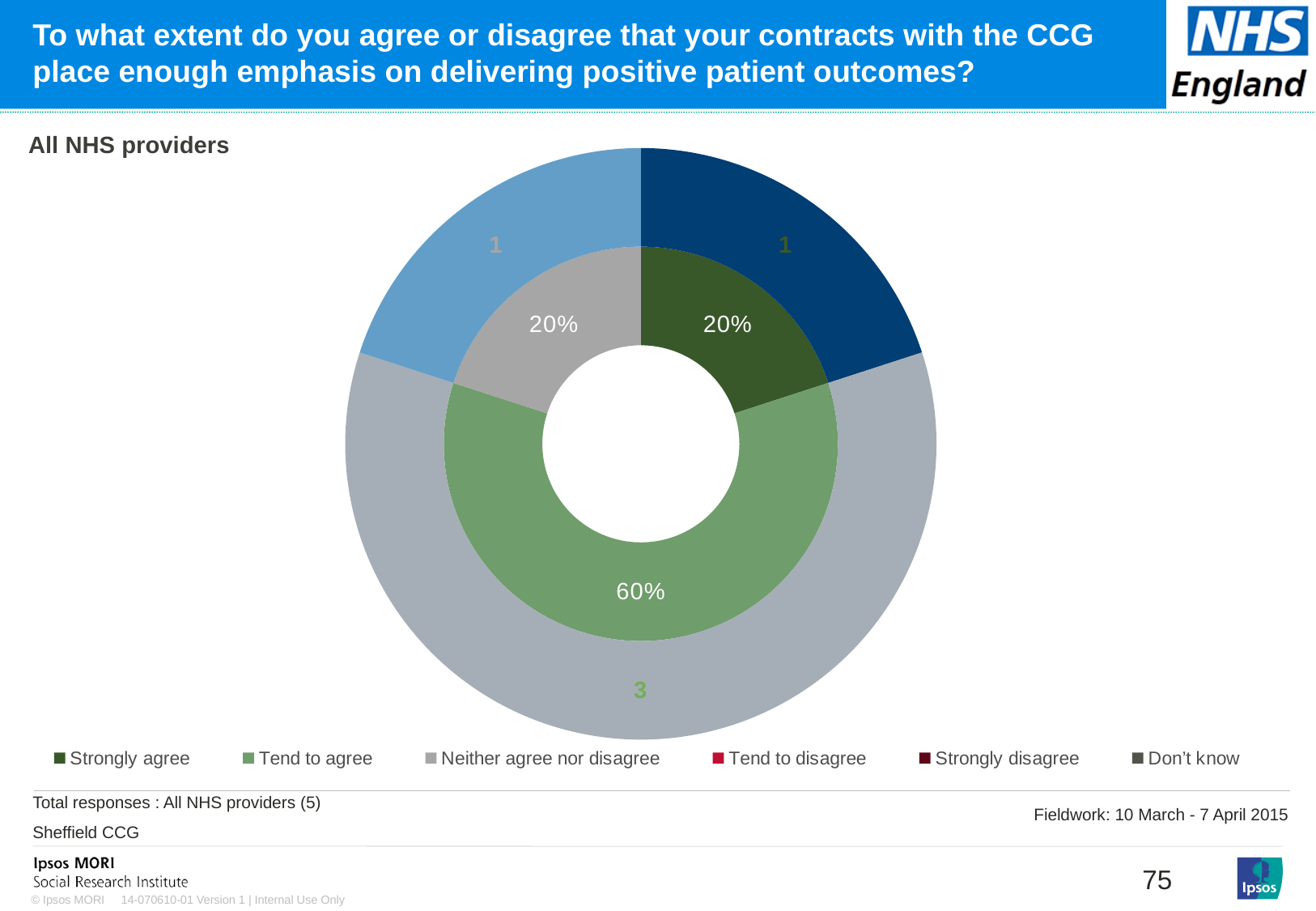
How many response categories does the legend list? 6 What percentage of respondents said they neither agree nor disagree? 20% How many responses are shown in the outer ring segment labelled for the largest category? 3 What kind of chart is shown on the slide? Doughnut chart Which CCG does this slide report on? Sheffield CCG What is the combined percentage for 'Strongly agree' and 'Tend to agree'? 80% What is the total number of responses from all NHS providers, as stated on the slide? 5 What percentage of respondents said they strongly agree? 20% Which response category has the largest share of the inner ring? Tend to agree What percentage of respondents said they tend to agree? 60% Which is larger, the share for 'Tend to agree' or the share for 'Neither agree nor disagree'? Tend to agree What is the difference in percentage points between 'Tend to agree' and 'Strongly agree'? 40